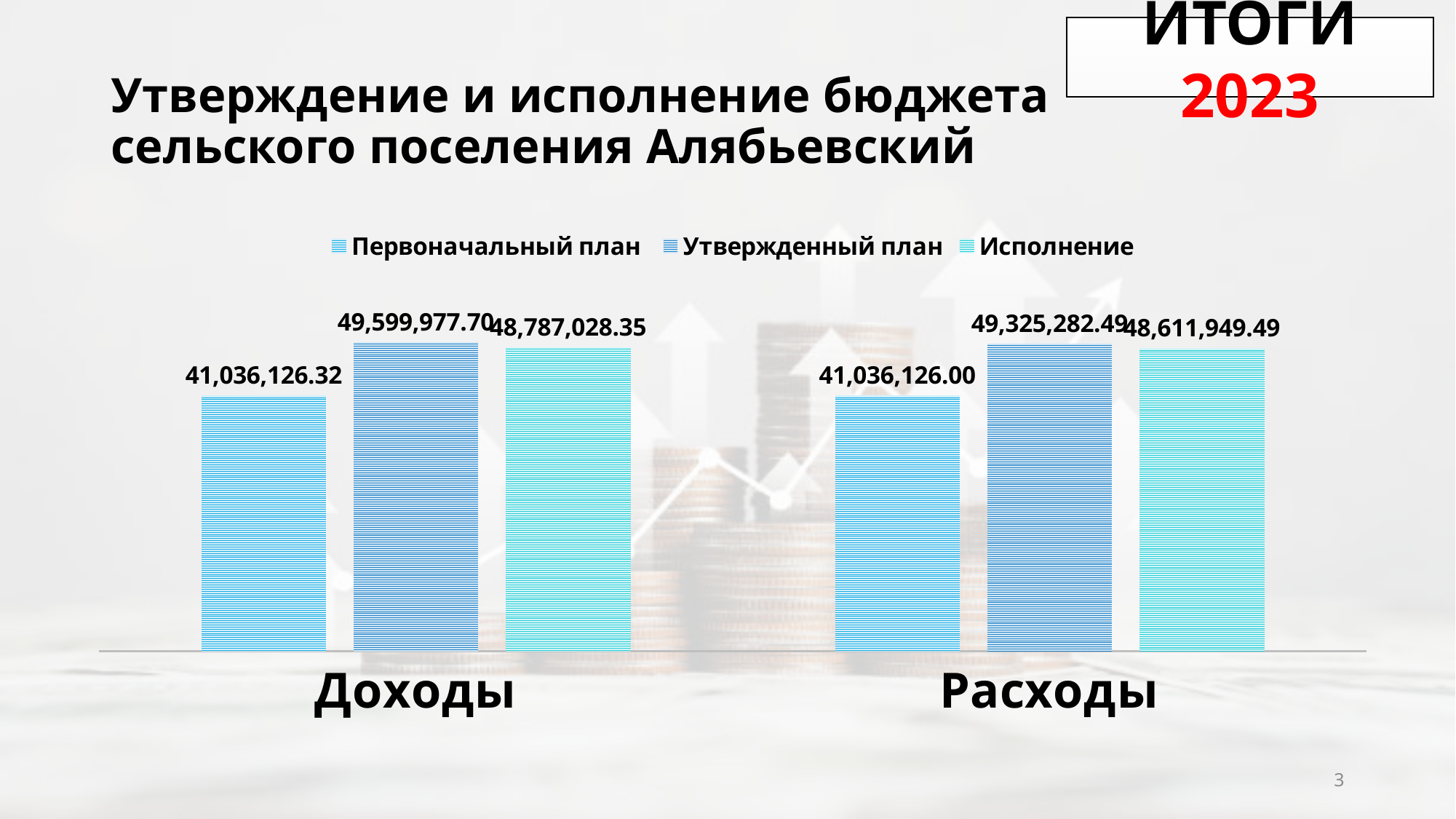
What is the difference between Исполнение for Доходы and Исполнение for Расходы? 175,078.86 What type of chart is shown on the slide? bar chart What is the value of Первоначальный план for Расходы? 41,036,126.00 What is the value of Исполнение for Доходы? 48,787,028.35 Which series has the highest value for Расходы? Утвержденный план Which series has the lowest value for Доходы? Первоначальный план What is the value of Первоначальный план for Доходы? 41,036,126.32 What is the difference between Исполнение and Первоначальный план for Доходы? 7,750,902.03 What is the value of Исполнение for Расходы? 48,611,949.49 Which is larger for Доходы: Утвержденный план or Исполнение? Утвержденный план How many categories are shown on the x axis? 2 How many series does the legend list? 3